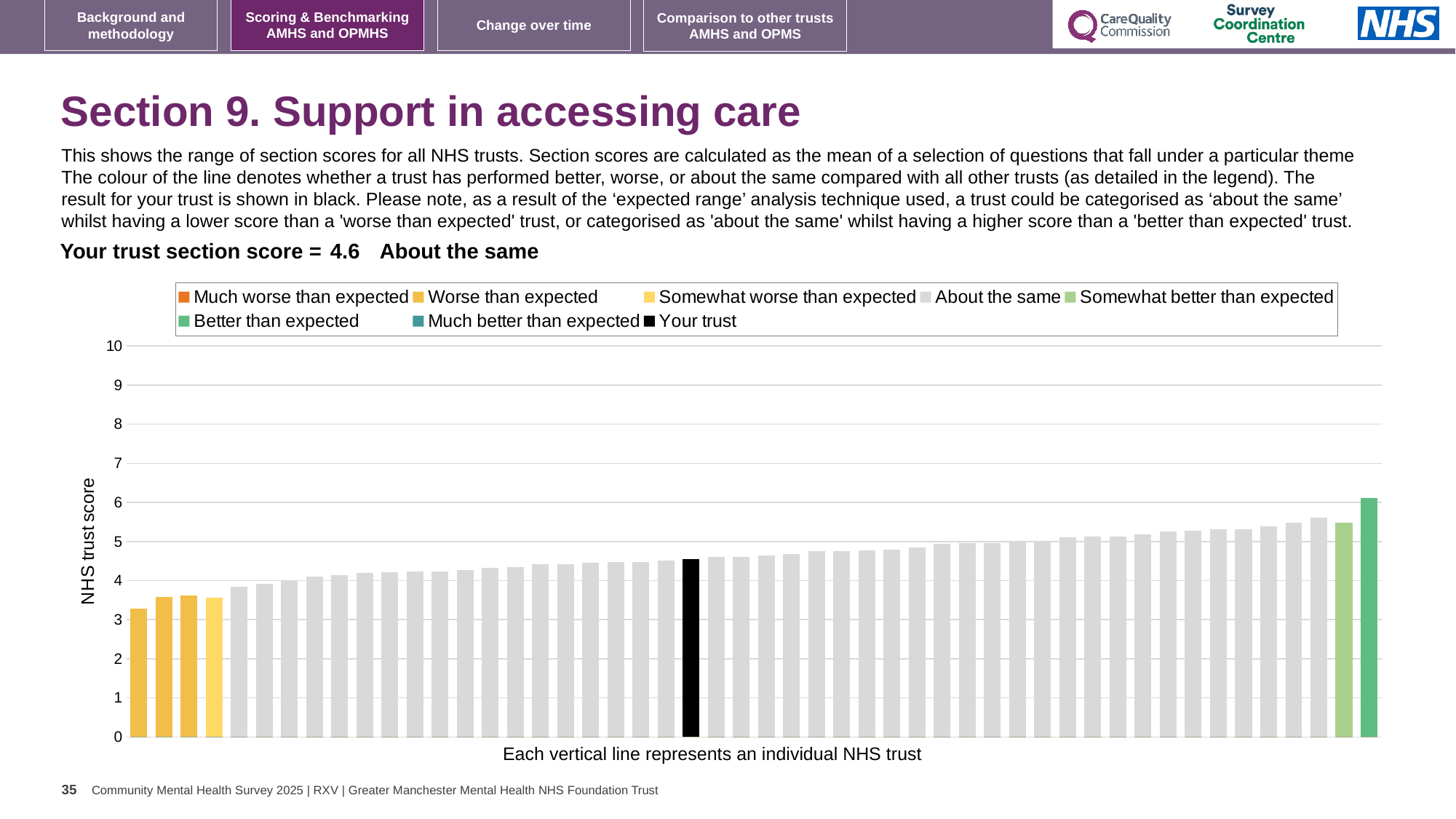
What colour is the bar representing your trust? Black How many bars are coloured yellow (Worse than expected) in the chart? 3 Do the bar values rise or fall from left to right along the x axis? Rise Is the value of the lowest bar in the chart greater or less than 4? less Which category is your trust placed in for this section? About the same What is the label on the vertical axis of the chart? NHS trust score What kind of chart is shown on the slide? Bar chart Is the value of the lowest bar in the chart greater or less than 3? greater How many entries does the chart legend list? 8 Is the value of the black 'Your trust' bar greater or less than 5? less What is the section score for your trust shown on the slide? 4.6